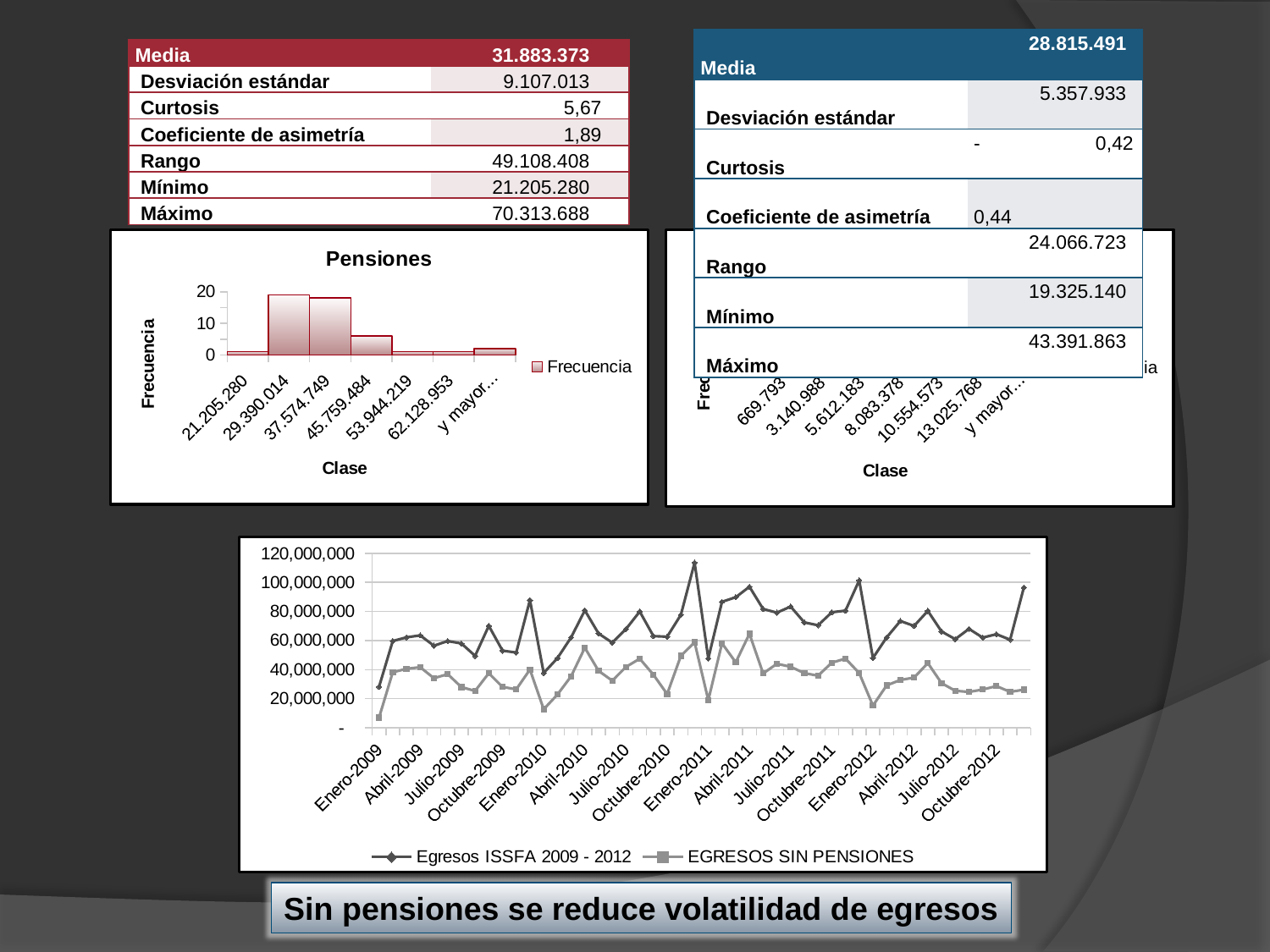
In the 'Pensiones' chart, which class has a higher frequency, 37.574.749 or 53.944.219? 37.574.749 How many series does the legend of the 'Pensiones' chart list? 1 What is the x-axis title of the 'Pensiones' chart? Clase In the 'Pensiones' chart, is the frequency for the class 29.390.014 greater or less than 10? greater How many categories are shown on the x axis of the chart at the top right of the slide? 7 In the bottom line chart, which series has the higher value at Enero-2009, 'Egresos ISSFA 2009 - 2012' or 'EGRESOS SIN PENSIONES'? Egresos ISSFA 2009 - 2012 How many series does the legend of the bottom line chart list? 2 In the 'Pensiones' chart, is the frequency for the class 45.759.484 greater or less than 10? less What kind of chart is the chart at the bottom of the slide? line chart In the bottom line chart, is the value of 'Egresos ISSFA 2009 - 2012' at Enero-2011 greater or less than 100,000,000? less What kind of chart is the 'Pensiones' chart at the top left of the slide? bar chart How many categories are shown on the x axis of the 'Pensiones' chart? 7